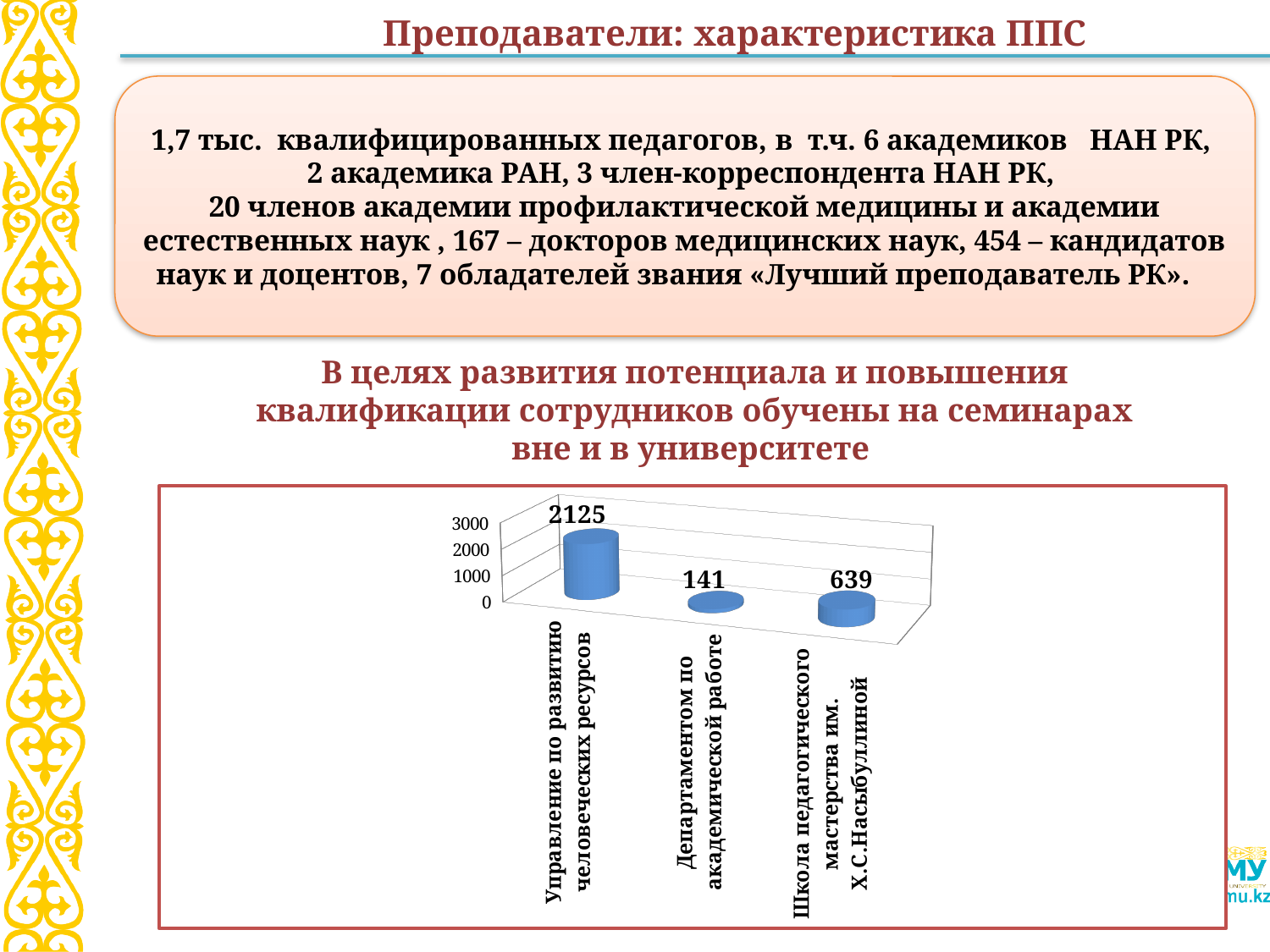
What value is shown for Управление по развитию человеческих ресурсов? 2125 What is the difference between the values for Школа педагогического мастерства им. Х.С.Насыбуллиной and Департаментом по академической работе? 498 How many categories are shown in the chart? 3 What is the difference between the values for Управление по развитию человеческих ресурсов and Школа педагогического мастерства им. Х.С.Насыбуллиной? 1486 What value is shown for Школа педагогического мастерства им. Х.С.Насыбуллиной? 639 What type of chart is shown on the slide? bar chart Which is larger: the value for Школа педагогического мастерства им. Х.С.Насыбуллиной or the value for Департаментом по академической работе? Школа педагогического мастерства им. Х.С.Насыбуллиной Which category has the highest value? Управление по развитию человеческих ресурсов Is the value for Управление по развитию человеческих ресурсов greater or less than 2000? greater Is the value for Школа педагогического мастерства им. Х.С.Насыбуллиной greater or less than 1000? less What value is shown for Департаментом по академической работе? 141 Which category has the lowest value? Департаментом по академической работе